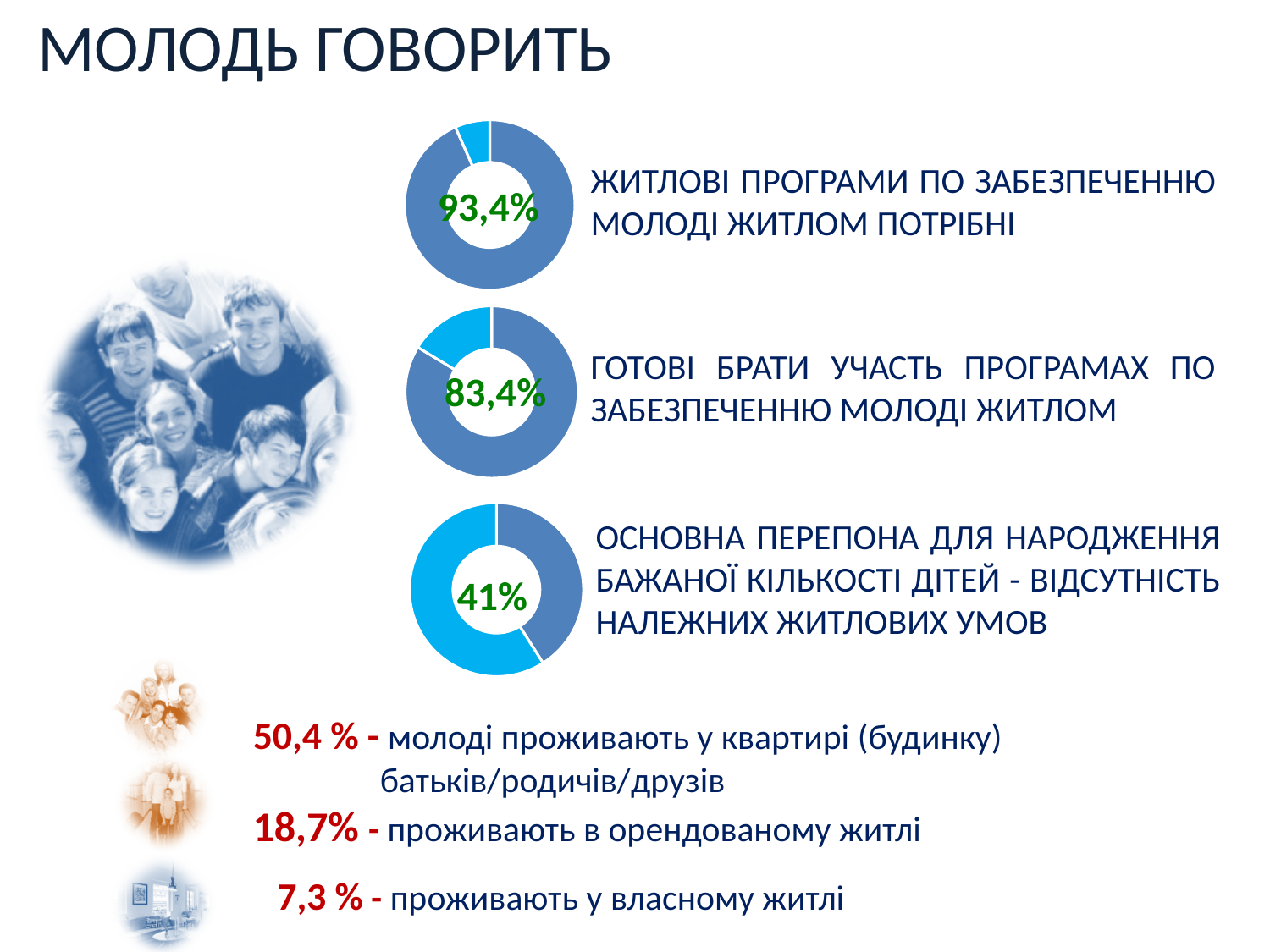
Which of the three doughnut charts shows the lowest printed value? the bottom chart (41%) How many doughnut charts are shown on the slide? 3 What value is printed in the centre of the bottom doughnut chart (next to 'ОСНОВНА ПЕРЕПОНА ДЛЯ НАРОДЖЕННЯ БАЖАНОЇ КІЛЬКОСТІ ДІТЕЙ')? 41% What is the difference between the value in the top doughnut chart and the value in the middle doughnut chart? 10% What is the difference between the value in the middle doughnut chart and the value in the bottom doughnut chart? 42,4% Which of the three doughnut charts shows the highest printed value? the top chart (93,4%) Which is larger: the value in the middle doughnut chart or the value in the bottom doughnut chart? the middle chart (83,4%) What value is printed in the centre of the top doughnut chart? 93,4% What value is printed in the centre of the middle doughnut chart (next to 'ГОТОВІ БРАТИ УЧАСТЬ ПРОГРАМАХ ПО ЗАБЕЗПЕЧЕННЮ МОЛОДІ ЖИТЛОМ')? 83,4% What kind of chart is the top chart next to the text 'ЖИТЛОВІ ПРОГРАМИ ПО ЗАБЕЗПЕЧЕННЮ МОЛОДІ ЖИТЛОМ ПОТРІБНІ'? doughnut chart How many slices does each doughnut chart on the slide have? 2 In the top doughnut chart, what colour is the larger slice? dark blue